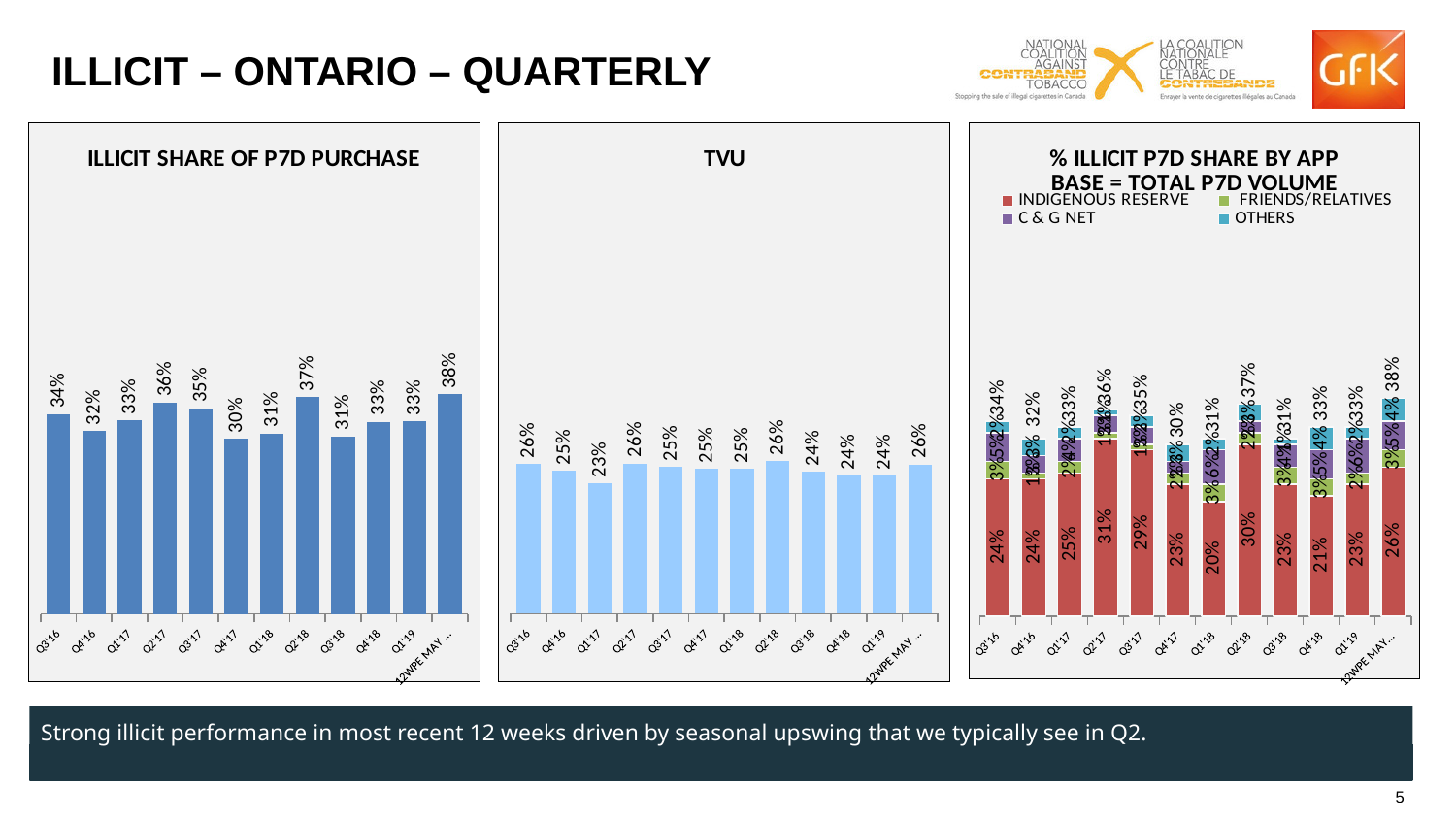
In the ILLICIT SHARE OF P7D PURCHASE chart, how many bars are plotted? 12 In the TVU chart, is the value for Q3'16 larger or smaller than the value for Q3'18? larger In the ILLICIT SHARE OF P7D PURCHASE chart, what is the value for Q2'18? 37% In the ILLICIT SHARE OF P7D PURCHASE chart, what is the difference between the values for Q2'17 and Q4'17? 6% In the % ILLICIT P7D SHARE BY APP chart, what is the INDIGENOUS RESERVE value for Q2'17? 31% In the TVU chart, which period has the lowest value? Q1'17 What kind of chart is the TVU chart? bar chart In the % ILLICIT P7D SHARE BY APP chart, how many series does the legend list? 4 In the ILLICIT SHARE OF P7D PURCHASE chart, which period has the lowest value? Q4'17 In the TVU chart, what is the value for Q1'17? 23% In the % ILLICIT P7D SHARE BY APP chart, which period has the lowest INDIGENOUS RESERVE value? Q1'18 In the ILLICIT SHARE OF P7D PURCHASE chart, which period has the highest value? 12WPE MAY